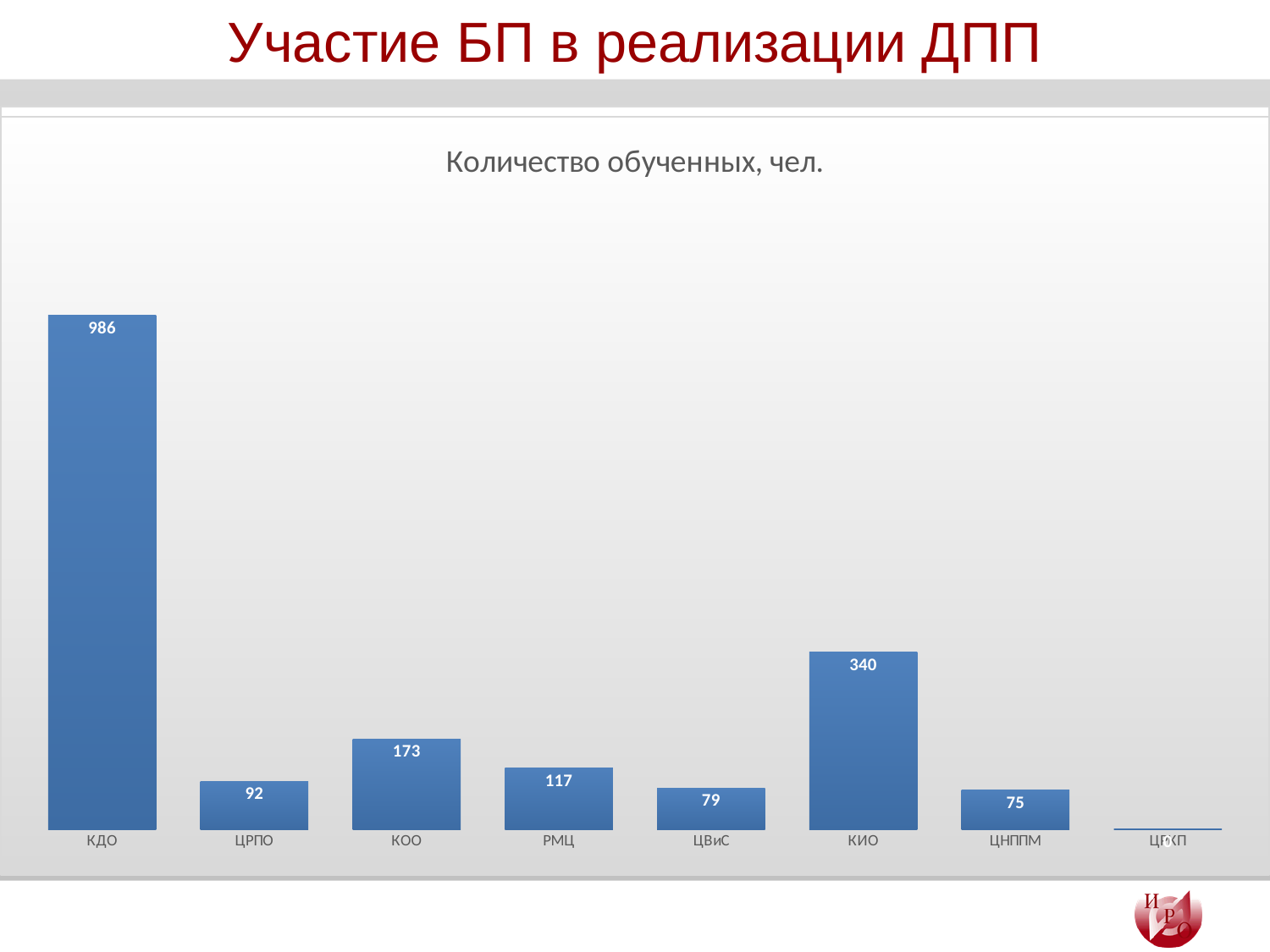
What is the difference between the values for КДО and КИО? 646 How many categories are shown on the x axis? 8 What is the value for КДО? 986 What type of chart is shown on the slide? bar chart What is the value for РМЦ? 117 What is the difference between the values for КОО and РМЦ? 56 Which is larger, the value for ЦРПО or the value for ЦВиС? ЦРПО What is the title of the chart? Количество обученных, чел. What is the value for ЦНППМ? 75 Which category has the highest value? КДО What is the value for КИО? 340 Which is larger, the value for КОО or the value for КИО? КИО